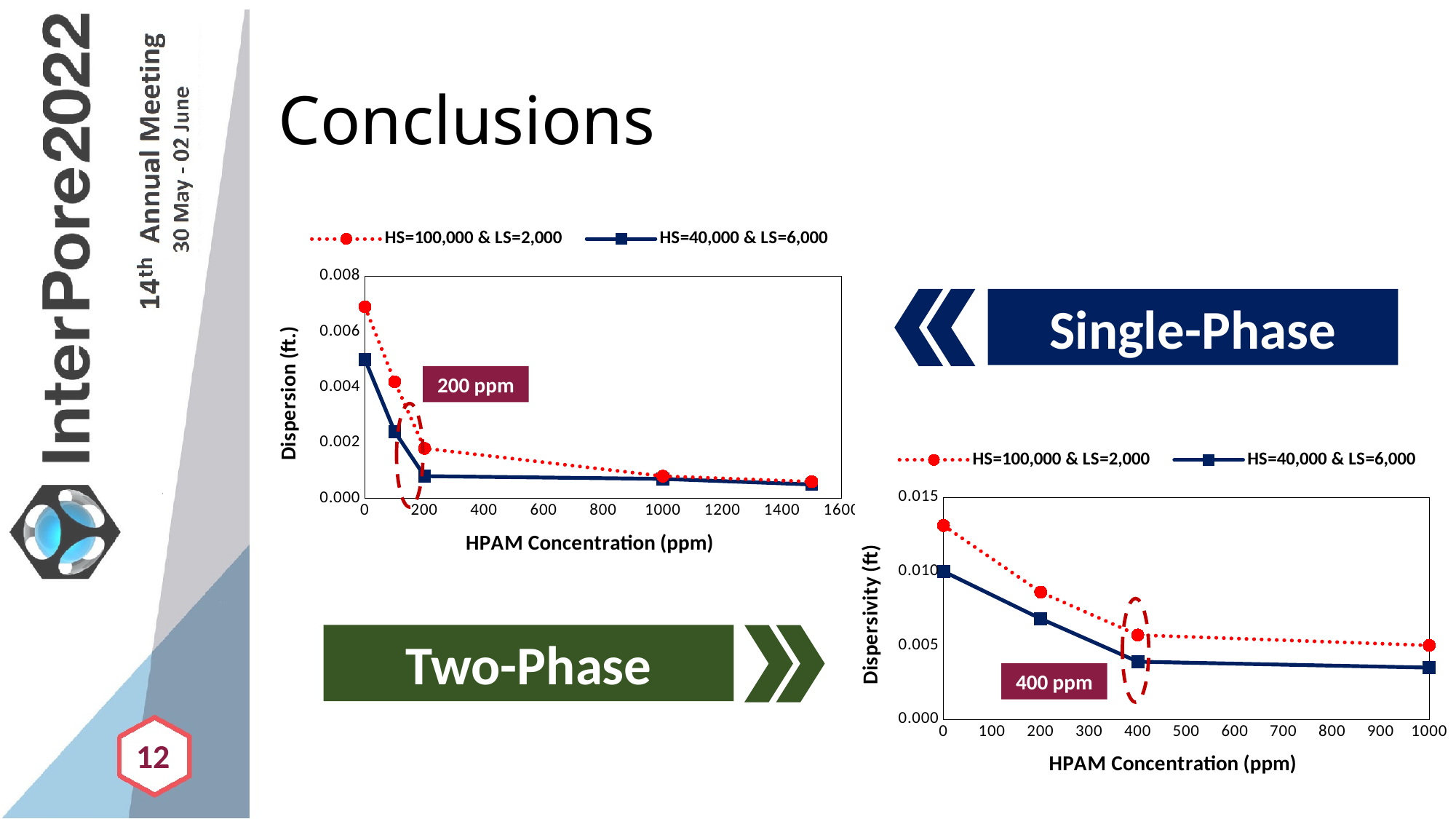
What kind of chart is the Two-Phase chart on the left of the slide? line chart In the Two-Phase chart on the left, is the dispersion for HS=40,000 & LS=6,000 at 0 ppm greater or less than 0.006? less How many series does the legend of the Two-Phase chart on the left list? 2 What concentration is highlighted by the annotation box in the Single-Phase chart on the right? 400 ppm In the Two-Phase chart on the left, is the dispersion for HS=100,000 & LS=2,000 at 0 ppm greater or less than 0.006? greater What is the y-axis label of the Single-Phase chart on the right? Dispersivity (ft) In the Two-Phase chart on the left, which series has the higher dispersion at 100 ppm? HS=100,000 & LS=2,000 In the Single-Phase chart on the right, does the HS=40,000 & LS=6,000 series rise or fall as HPAM concentration increases? fall In the Two-Phase chart on the left, does the HS=100,000 & LS=2,000 series rise or fall as HPAM concentration increases? fall In the Single-Phase chart on the right, is the dispersivity for HS=40,000 & LS=6,000 at 400 ppm greater or less than 0.005? less How many data points does each series have in the Single-Phase chart on the right? 4